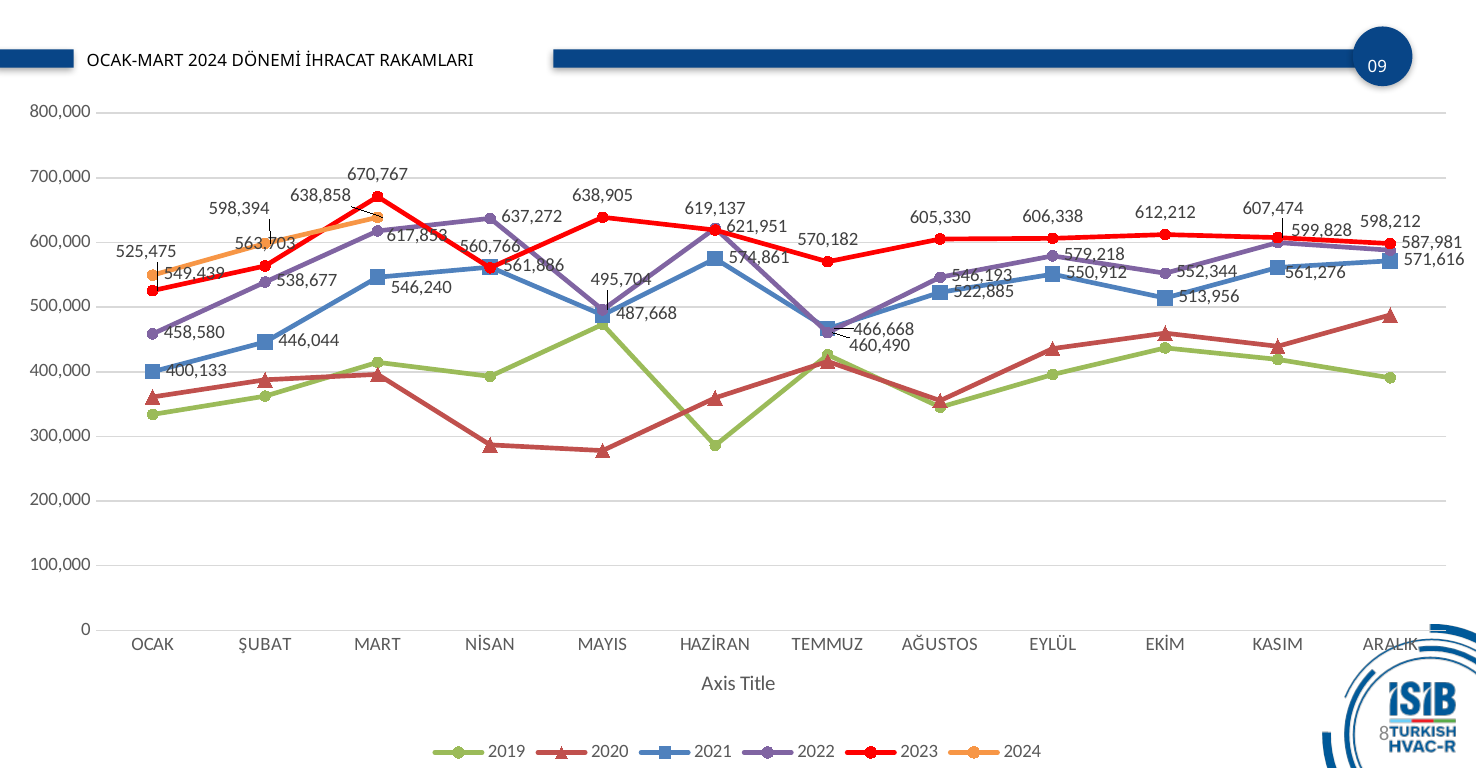
In which month does the 2023 series have its lowest value? OCAK In which month does the 2023 series reach its highest value? MART What is the difference between the 2024 values for MART and OCAK? 89,419 How many months are shown on the x axis? 12 Do the 2024 values rise or fall from OCAK to MART? rise What is the value for 2023 in MART? 670,767 What is the value for 2024 in MART? 638,858 How many series does the legend list? 6 Is the value for 2019 in HAZİRAN greater or less than 300,000? less Which is larger in MART, the 2023 value or the 2022 value? 2023 What type of chart is shown on the slide? line chart What is the value for 2024 in OCAK? 549,439